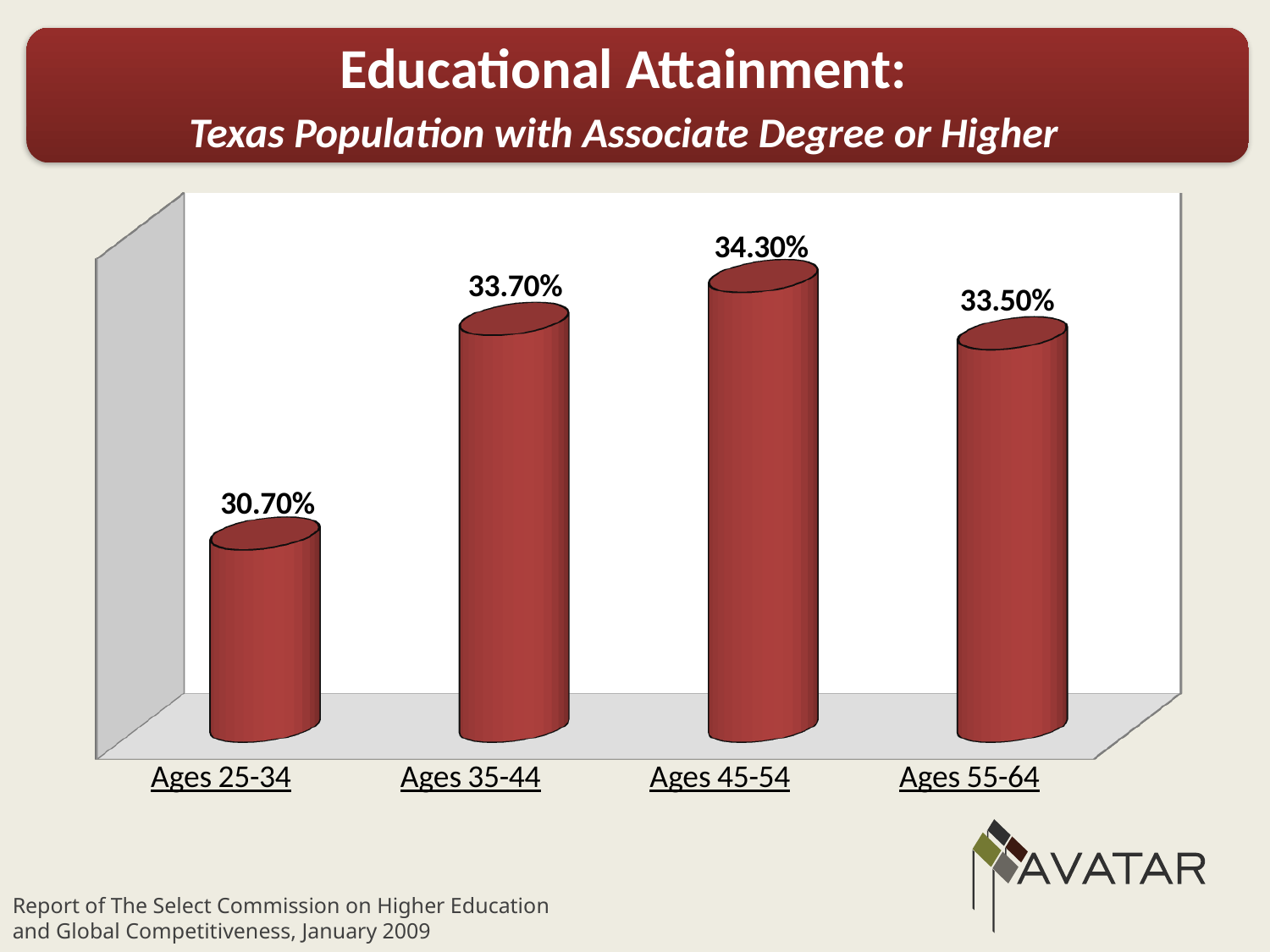
What is the difference between the values for Ages 35-44 and Ages 55-64? 0.20% What is the value for Ages 55-64? 33.50% Which is larger, the value for Ages 35-44 or the value for Ages 25-34? Ages 35-44 What is the subtitle of the chart on the slide? Texas Population with Associate Degree or Higher What is the difference between the values for Ages 45-54 and Ages 25-34? 3.60% Which age group has the highest value? Ages 45-54 What is the value for Ages 45-54? 34.30% What is the value for Ages 25-34? 30.70% How many age groups are shown in the chart? 4 Does the value rise or fall from Ages 25-34 to Ages 35-44? Rise Which age group has the lowest value? Ages 25-34 What kind of chart is shown on the slide? Bar chart